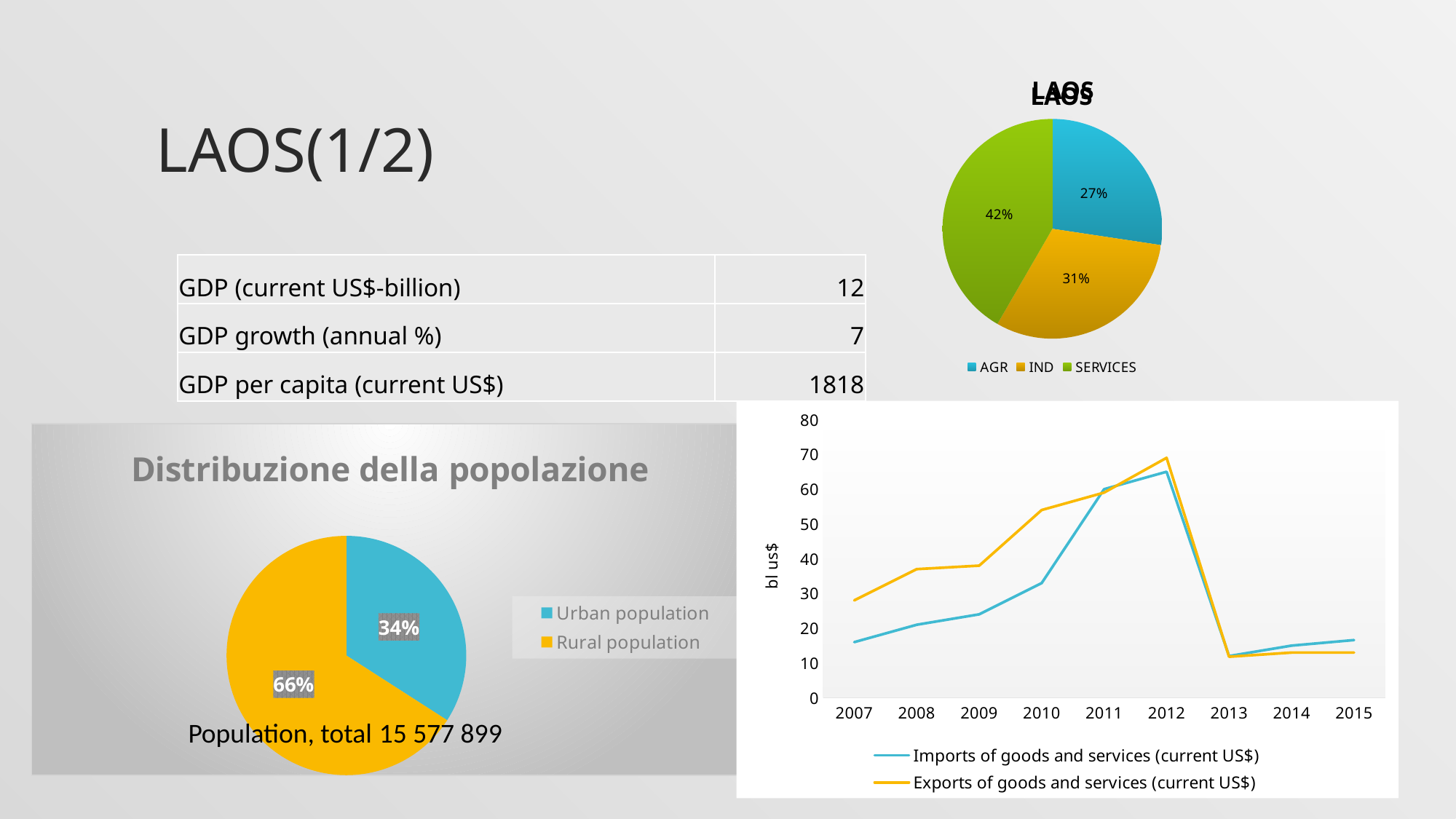
In the line chart at the bottom right, how many series does the legend list? 2 In the line chart at the bottom right, is the value for Exports of goods and services in 2012 greater or less than 60? greater In the pie chart titled LAOS at the top right, what share does SERVICES have? 42% In the pie chart titled LAOS at the top right, how many sectors does the legend list? 3 In the chart titled Distribuzione della popolazione, which is larger, Urban population or Rural population? Rural population In the pie chart titled LAOS at the top right, which sector has the smallest share? AGR In the line chart at the bottom right, how many years are shown on the x axis? 9 In the pie chart titled LAOS at the top right, which sector has the largest share? SERVICES In the pie chart titled LAOS at the top right, what share does AGR have? 27% In the pie chart titled LAOS at the top right, what is the difference in percentage points between SERVICES and IND? 11 What kind of chart is the Distribuzione della popolazione chart? Pie chart In the chart titled Distribuzione della popolazione, what share is Rural population? 66%